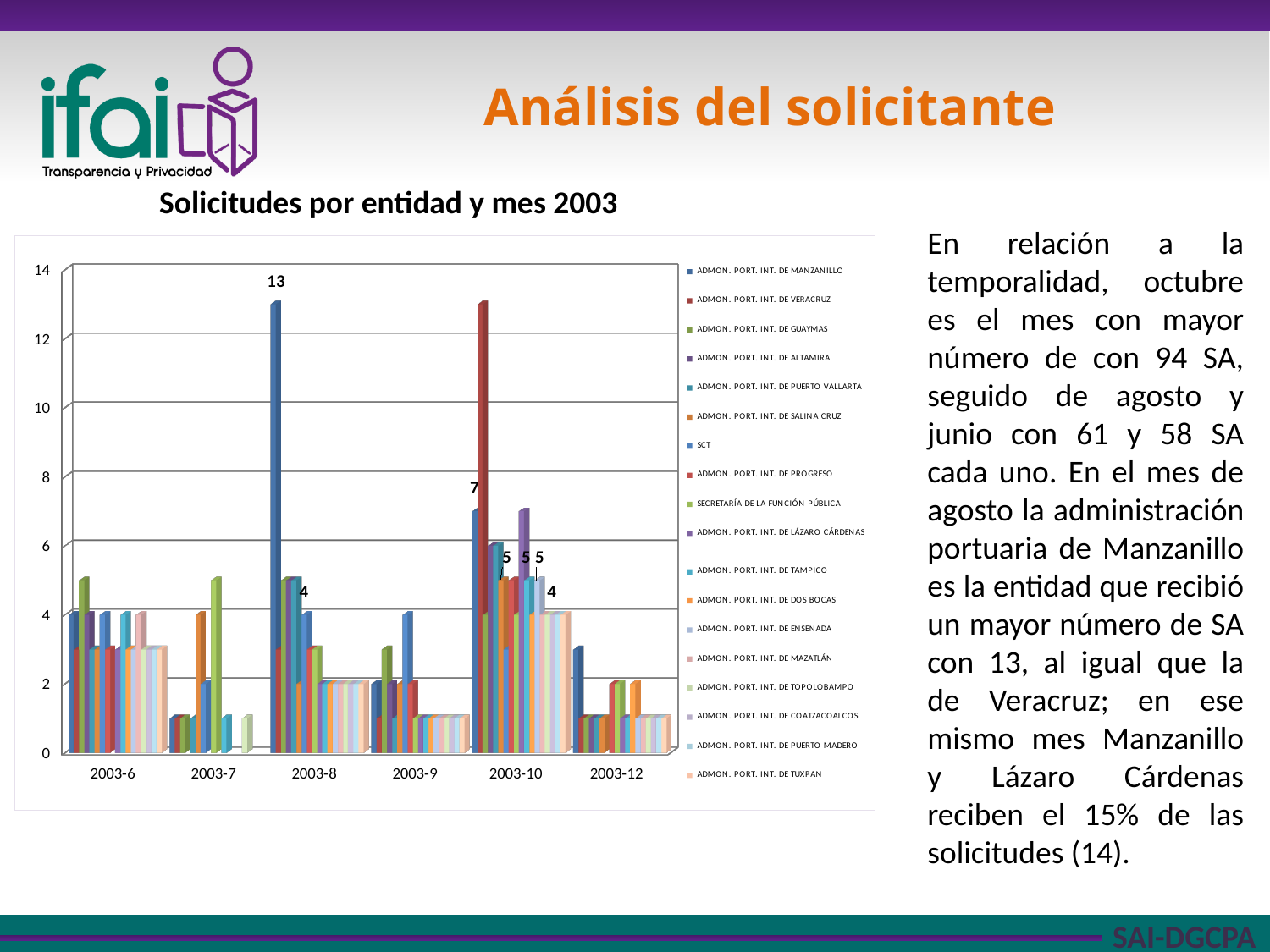
What is the title of the chart? Solicitudes por entidad y mes 2003 What kind of chart is shown on the slide? Bar chart What is the difference between the ADMON. PORT. INT. DE MANZANILLO values in 2003-8 and 2003-10? 6 In which month does ADMON. PORT. INT. DE MANZANILLO reach its highest value? 2003-8 What is the value for ADMON. PORT. INT. DE MANZANILLO in 2003-8? 13 Which series is listed first in the chart legend? ADMON. PORT. INT. DE MANZANILLO How many month categories are shown on the x axis of the chart? 6 How many series does the chart legend list? 18 Which is larger for ADMON. PORT. INT. DE MANZANILLO: the value in 2003-8 or in 2003-10? 2003-8 What is the value for ADMON. PORT. INT. DE MANZANILLO in 2003-10? 7 Is the value for ADMON. PORT. INT. DE MANZANILLO in 2003-6 greater or less than 6? less Is the value for ADMON. PORT. INT. DE VERACRUZ in 2003-10 greater or less than 12? greater